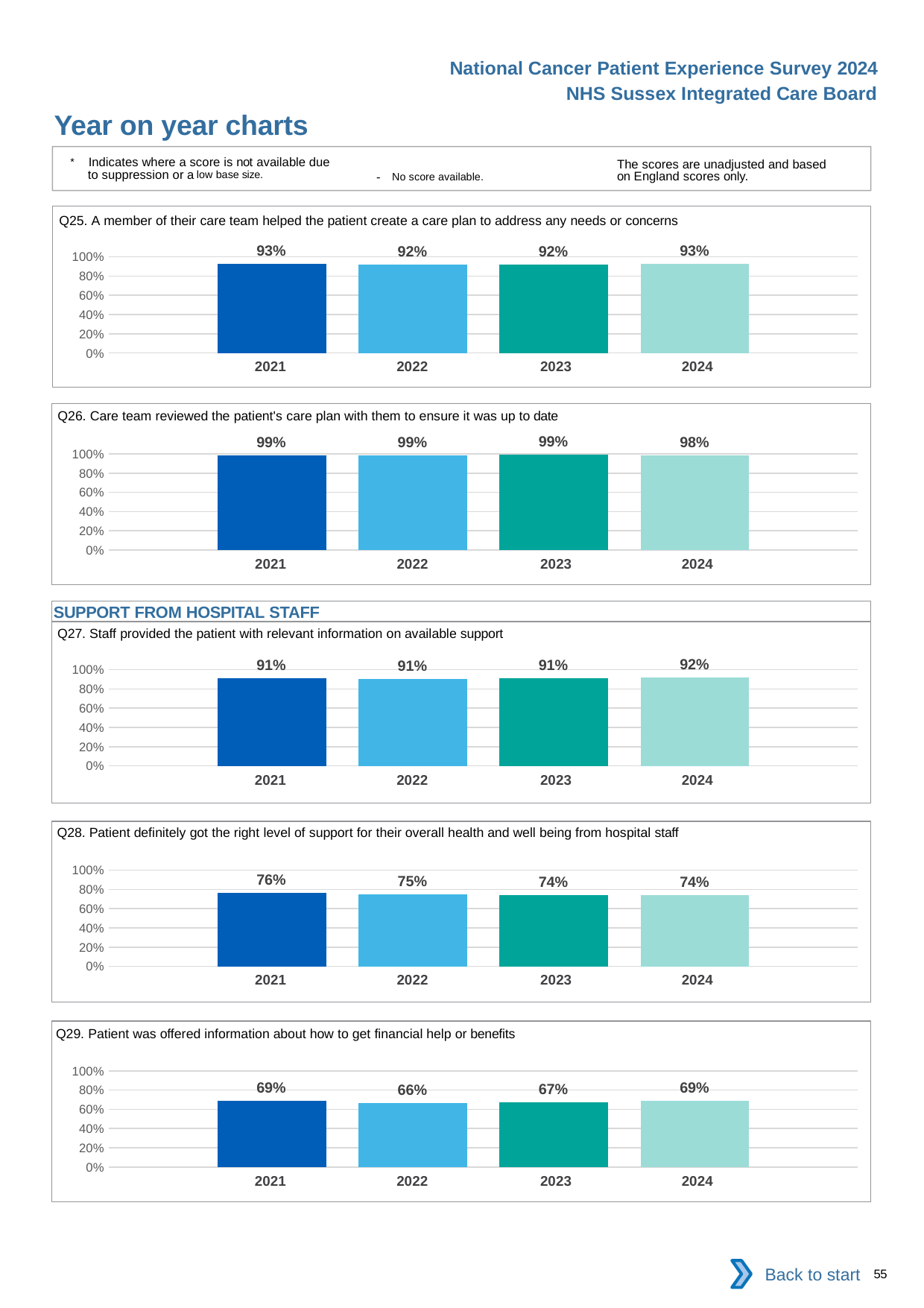
In the Q26 chart, what is the value for 2024? 98% In the Q27 chart, which year has the highest value? 2024 In the Q27 chart, what is the value for 2022? 91% What kind of chart is the Q26 chart? bar chart In the Q29 chart, which year has the lowest value? 2022 In the Q28 chart, do the values rise or fall from 2021 to 2023? fall How many charts are shown on the slide? 5 How many years are shown in the Q25 chart? 4 In the Q29 chart, is the value for 2022 larger or smaller than the value for 2023? smaller In the Q28 chart, what is the difference between the 2021 value and the 2024 value? 2% In the Q28 chart, is the value for 2023 greater or less than 80%? less In the Q25 chart, what is the value for 2021? 93%